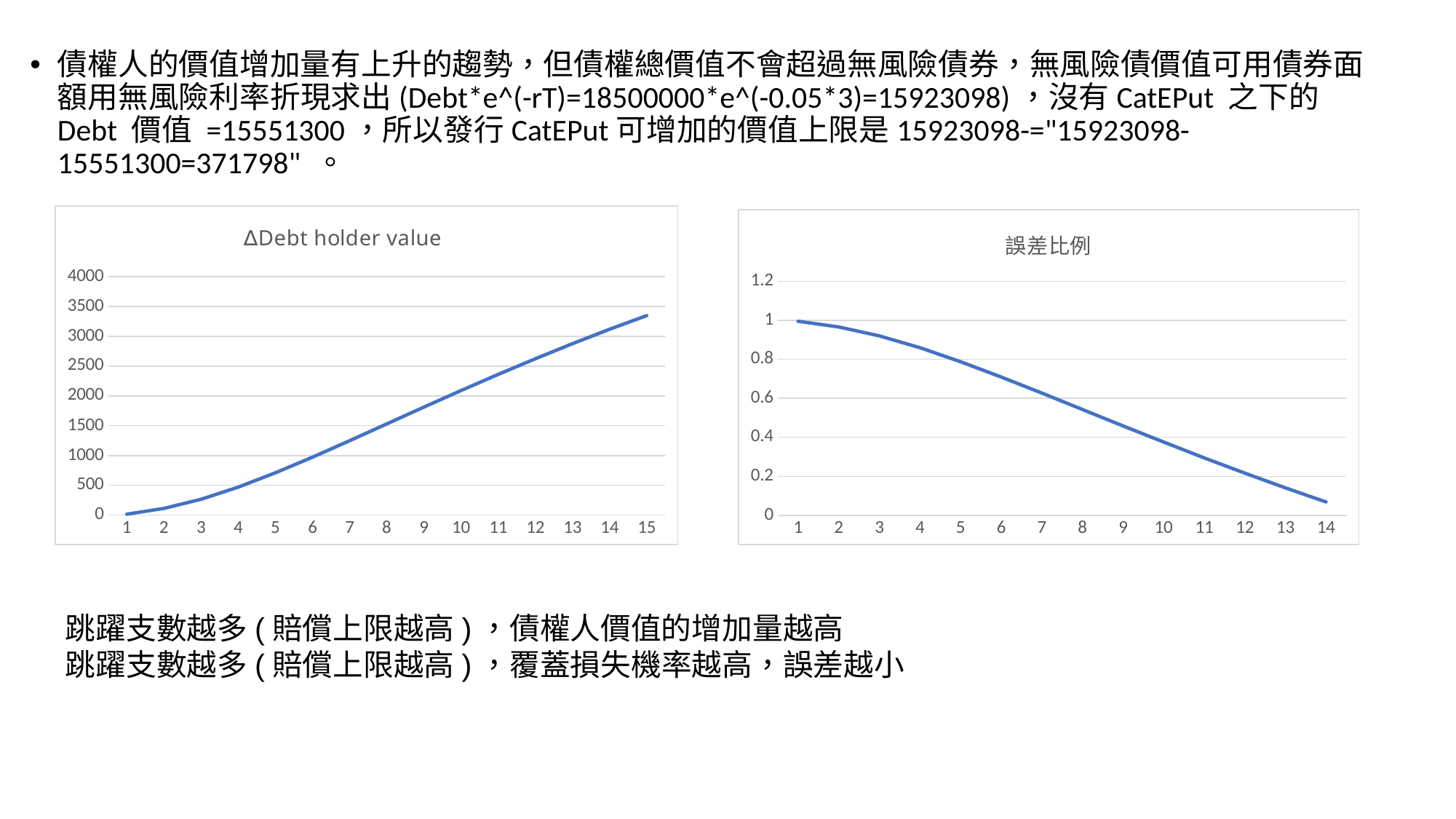
In the "ΔDebt holder value" chart, is the value at x = 15 greater or less than 3000? greater In the "ΔDebt holder value" chart, is the value at x = 2 greater or less than 500? less In the "誤差比例" chart, do the values rise or fall along the x axis? fall What kind of chart is the "誤差比例" chart? line chart In the "ΔDebt holder value" chart, do the values rise or fall along the x axis? rise In the "ΔDebt holder value" chart, at which x value is the plotted value highest? 15 In the "誤差比例" chart, is the value at x = 14 greater or less than 0.2? less How many points are plotted along the x axis of the "誤差比例" chart? 14 What kind of chart is the "ΔDebt holder value" chart? line chart How many points are plotted along the x axis of the "ΔDebt holder value" chart? 15 In the "誤差比例" chart, at which x value is the plotted value lowest? 14